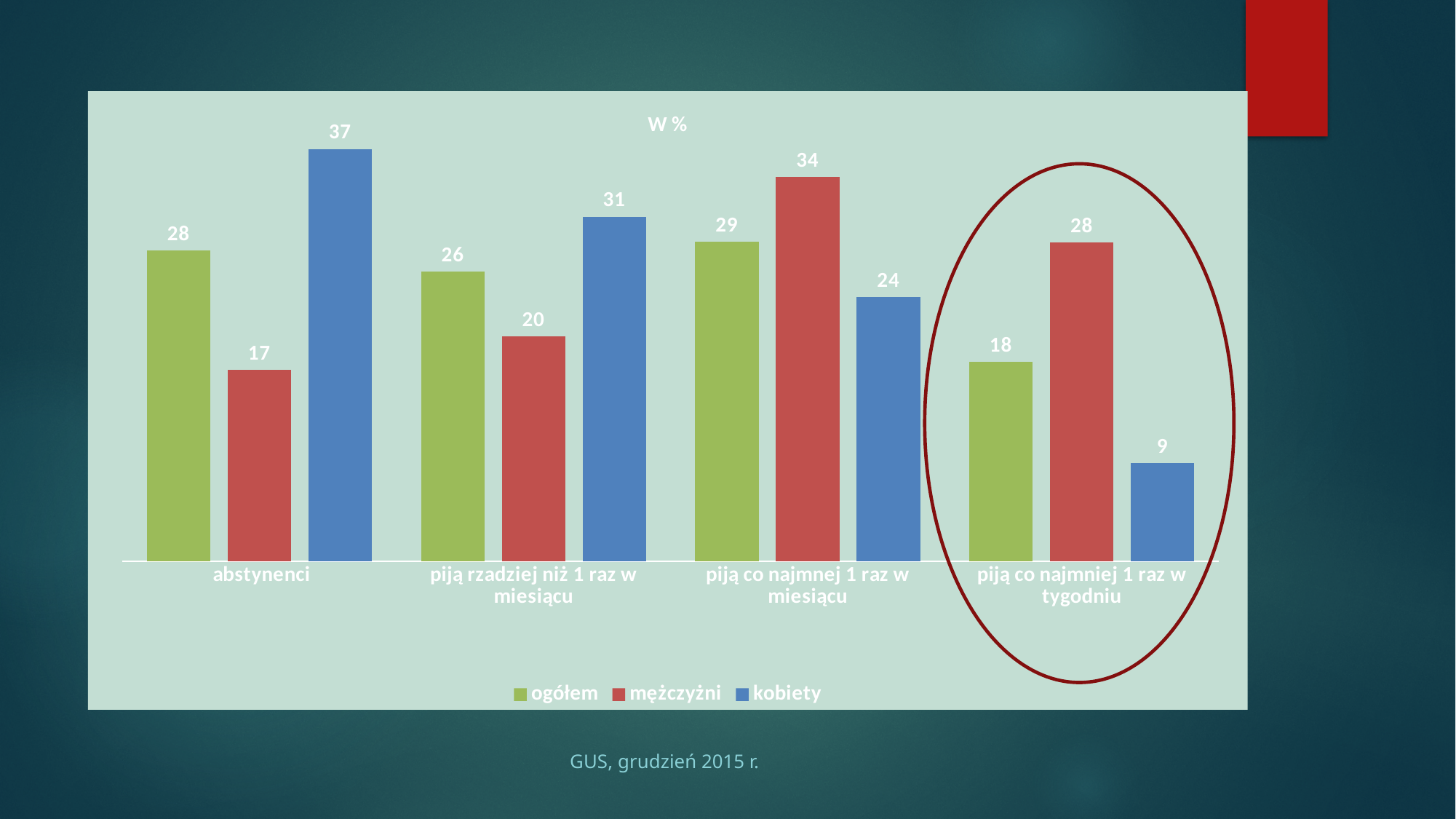
How many series does the legend list? 3 Which category has the lowest value for kobiety? piją co najmniej 1 raz w tygodniu Which category has the highest value for mężczyźni? piją co najmniej 1 raz w miesiącu What is the value for mężczyźni in the 'piją co najmniej 1 raz w miesiącu' category? 34 How many categories are shown on the x axis? 4 What kind of chart is shown on the slide? bar chart In the 'piją rzadziej niż 1 raz w miesiącu' category, which is larger: the value for kobiety or for mężczyźni? kobiety What is the value for kobiety in the abstynenci category? 37 What is the value for ogółem in the 'piją co najmniej 1 raz w tygodniu' category? 18 What is the title of the chart? W % Which series is shown in blue? kobiety What is the difference between the kobiety and mężczyźni values in the abstynenci category? 20